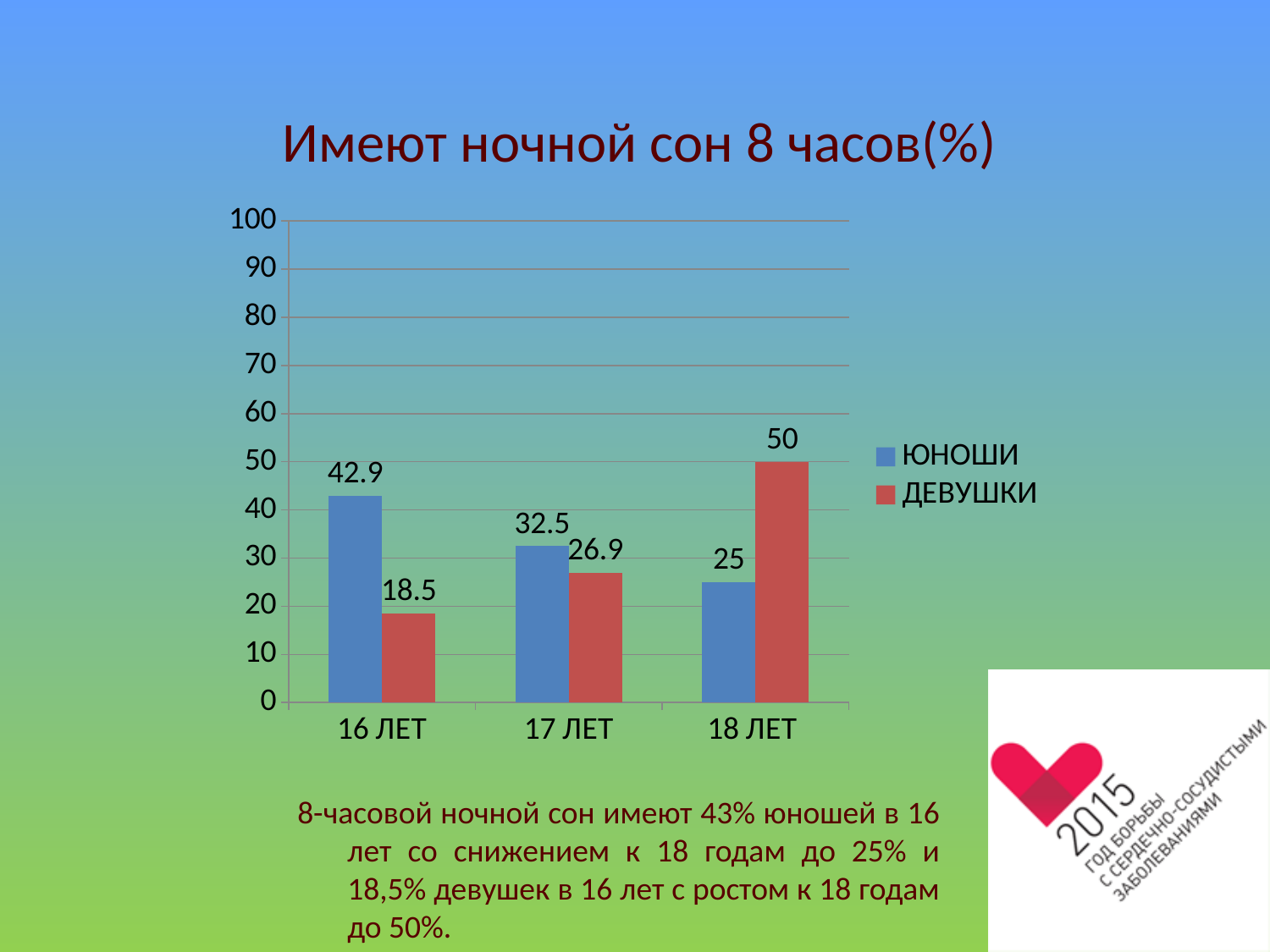
How many series does the legend list? 2 At which age group is the ДЕВУШКИ value highest? 18 ЛЕТ Is the value for ЮНОШИ at 17 ЛЕТ greater or less than 30? greater What is the difference between the ЮНОШИ and ДЕВУШКИ values at 16 ЛЕТ? 24.4 What kind of chart is shown on the slide? bar chart What is the value for ЮНОШИ at 16 ЛЕТ? 42.9 How many age groups are shown on the x axis? 3 At which age group is the ЮНОШИ value lowest? 18 ЛЕТ Do the ЮНОШИ values rise or fall from 16 ЛЕТ to 18 ЛЕТ? fall What is the value for ДЕВУШКИ at 18 ЛЕТ? 50 Which is larger at 18 ЛЕТ, ЮНОШИ or ДЕВУШКИ? ДЕВУШКИ What is the value for ДЕВУШКИ at 17 ЛЕТ? 26.9